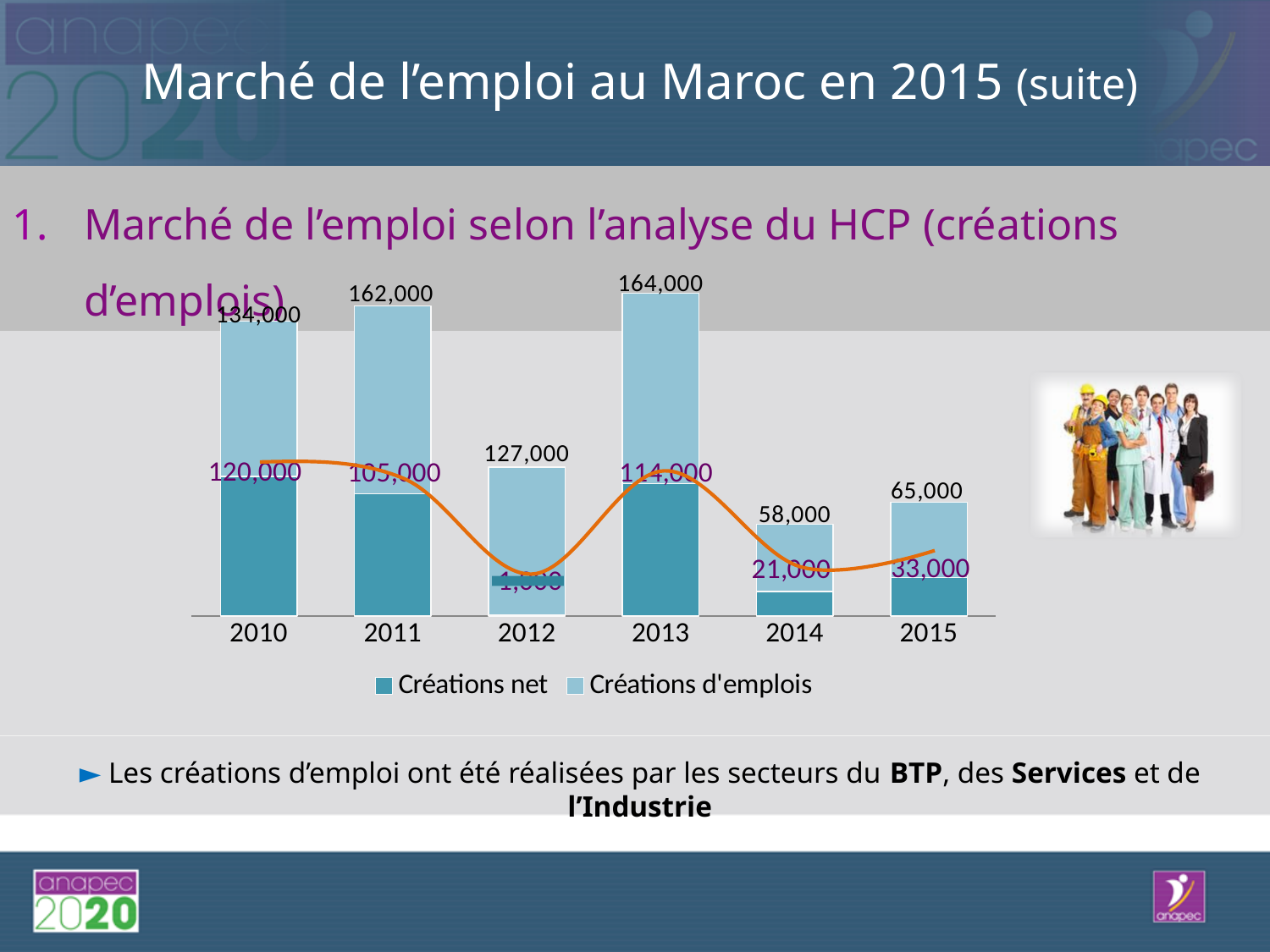
Which year has the highest value for Créations d'emplois? 2013 Does the value of Créations d'emplois rise or fall from 2013 to 2014? Fall Which year has the lowest value for Créations d'emplois? 2014 What is the value of Créations d'emplois for 2013? 164,000 What kind of chart is shown on the slide? Bar chart What is the value of Créations net for 2015? 33,000 What is the difference between Créations d'emplois and Créations net in 2011? 57,000 How many series does the chart legend list? 2 What is the value of Créations net for 2010? 120,000 What is the difference between Créations d'emplois in 2013 and in 2014? 106,000 How many years are shown on the x axis of the chart? 6 Which year has the larger value for Créations d'emplois, 2014 or 2015? 2015